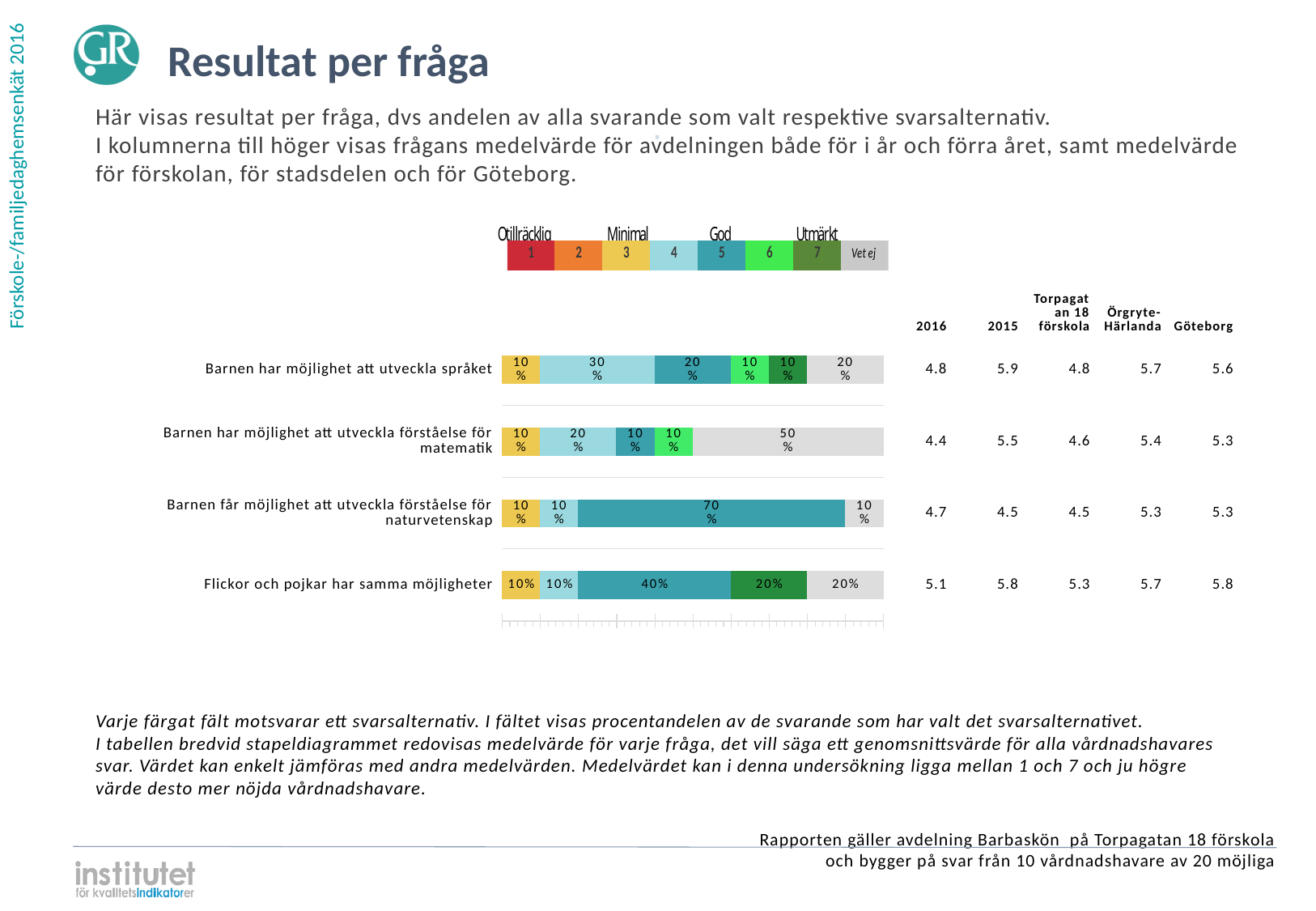
What kind of chart is shown on the slide? Stacked bar chart What label does the legend give to the grey segment? Vet ej How many questions (categories) are plotted in the bar chart? 4 What share of respondents chose alternative 4 for 'Barnen har möjlighet att utveckla språket'? 30% What is the largest segment in the bar for 'Barnen får möjlighet att utveckla förståelse för naturvetenskap'? 70% Which is larger: the alternative 5 share for 'Flickor och pojkar har samma möjligheter' or the alternative 5 share for 'Barnen har möjlighet att utveckla språket'? Flickor och pojkar har samma möjligheter What share of respondents chose 'Vet ej' for 'Barnen har möjlighet att utveckla förståelse för matematik'? 50% What is the difference between the 'Vet ej' share for the matematik question and the 'Vet ej' share for the språket question? 30% What is the total of the segments in the bar for 'Barnen har möjlighet att utveckla språket'? 100% Which question has the largest single segment in its bar? Barnen får möjlighet att utveckla förståelse för naturvetenskap How many answer alternatives does the legend above the chart list? 8 What share of respondents chose alternative 7 for 'Flickor och pojkar har samma möjligheter'? 20%